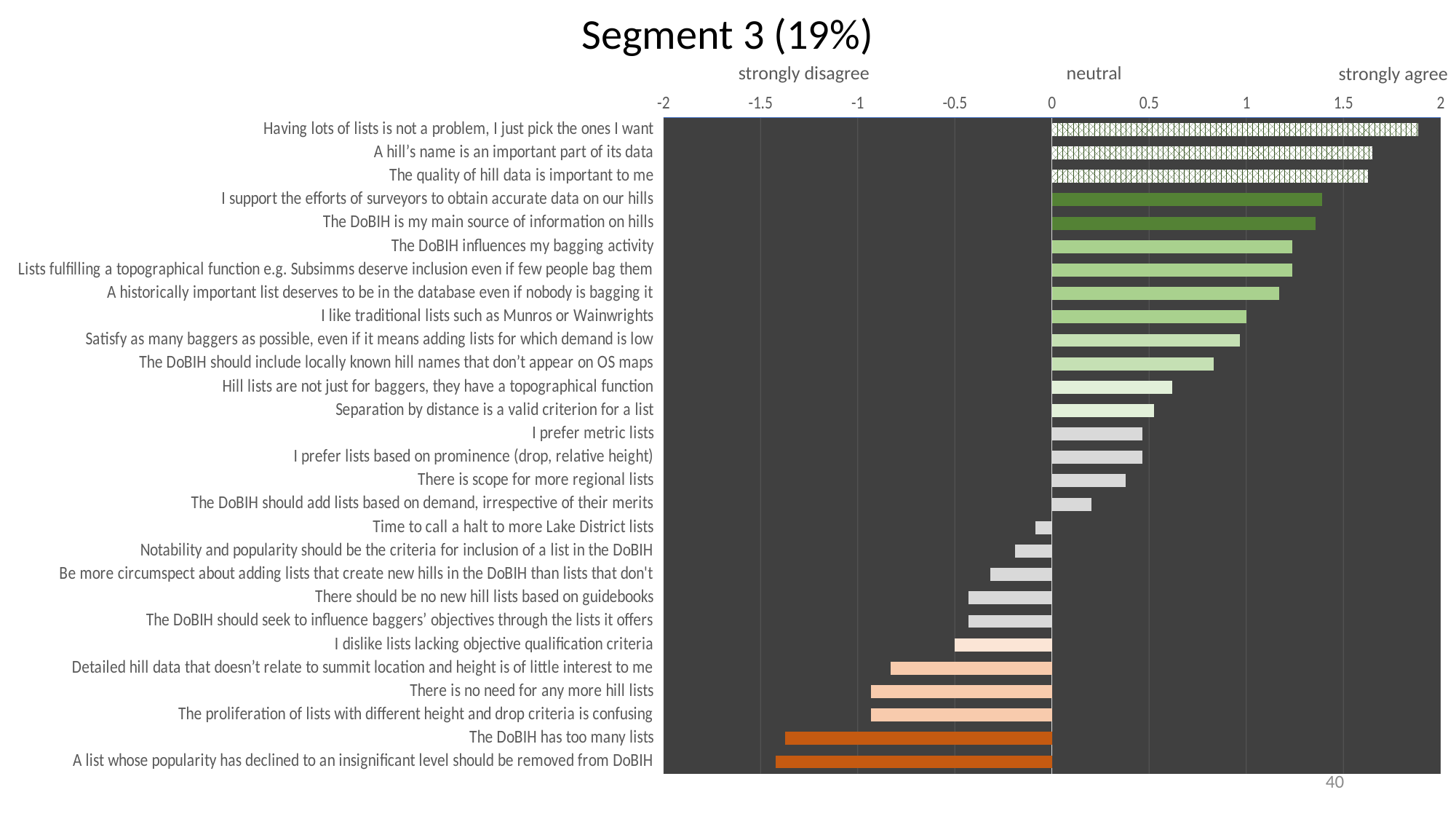
Is the value for "Having lots of lists is not a problem, I just pick the ones I want" greater or less than 1.5? greater What is the title of the chart? Segment 3 (19%) Which statement has the highest value in the chart? Having lots of lists is not a problem, I just pick the ones I want Is the value for "Detailed hill data that doesn't relate to summit location and height is of little interest to me" greater or less than -0.5? less Which has the higher value: "The DoBIH influences my bagging activity" or "Hill lists are not just for baggers, they have a topographical function"? The DoBIH influences my bagging activity Is the value for "There is scope for more regional lists" greater or less than 0.5? less What kind of chart is shown on the slide? bar chart How many statements (categories) are plotted in the chart? 28 What label appears at the right end of the horizontal axis, above the value 2? strongly agree